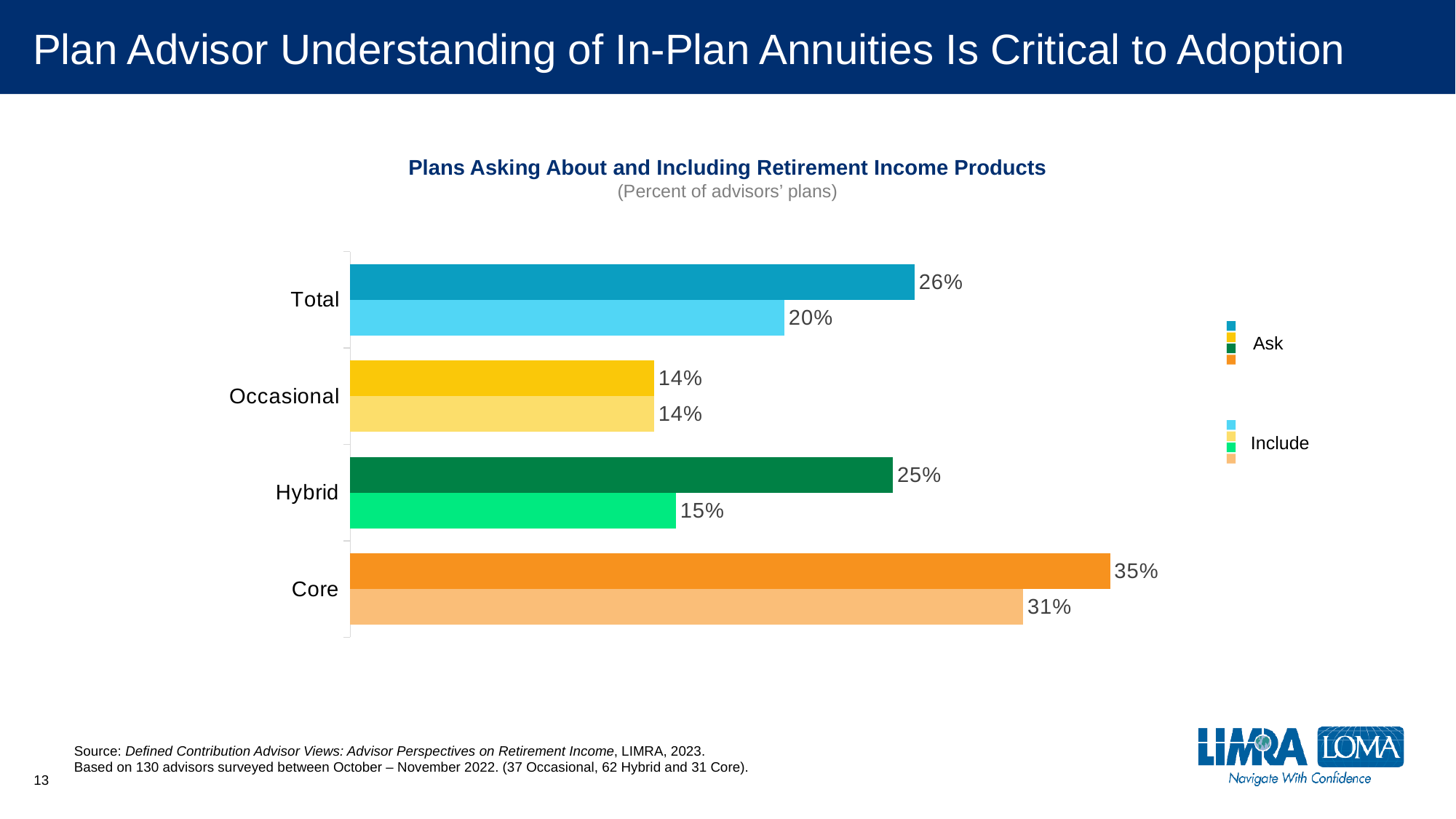
What is the difference between the Ask values for Core and Total? 9% What is the difference between the Ask and Include values for Hybrid? 10% Which category has the lowest Include value? Occasional What is the Ask value for Occasional? 14% What is the Ask value for Core? 35% How many series does the legend list? 2 What is the Include value for Hybrid? 15% How many categories are shown on the chart? 4 What kind of chart is shown on the slide? Bar chart Which category has the highest Ask value? Core Which is larger, the Include value for Core or the Ask value for Total? Include value for Core What is the Include value for Total? 20%